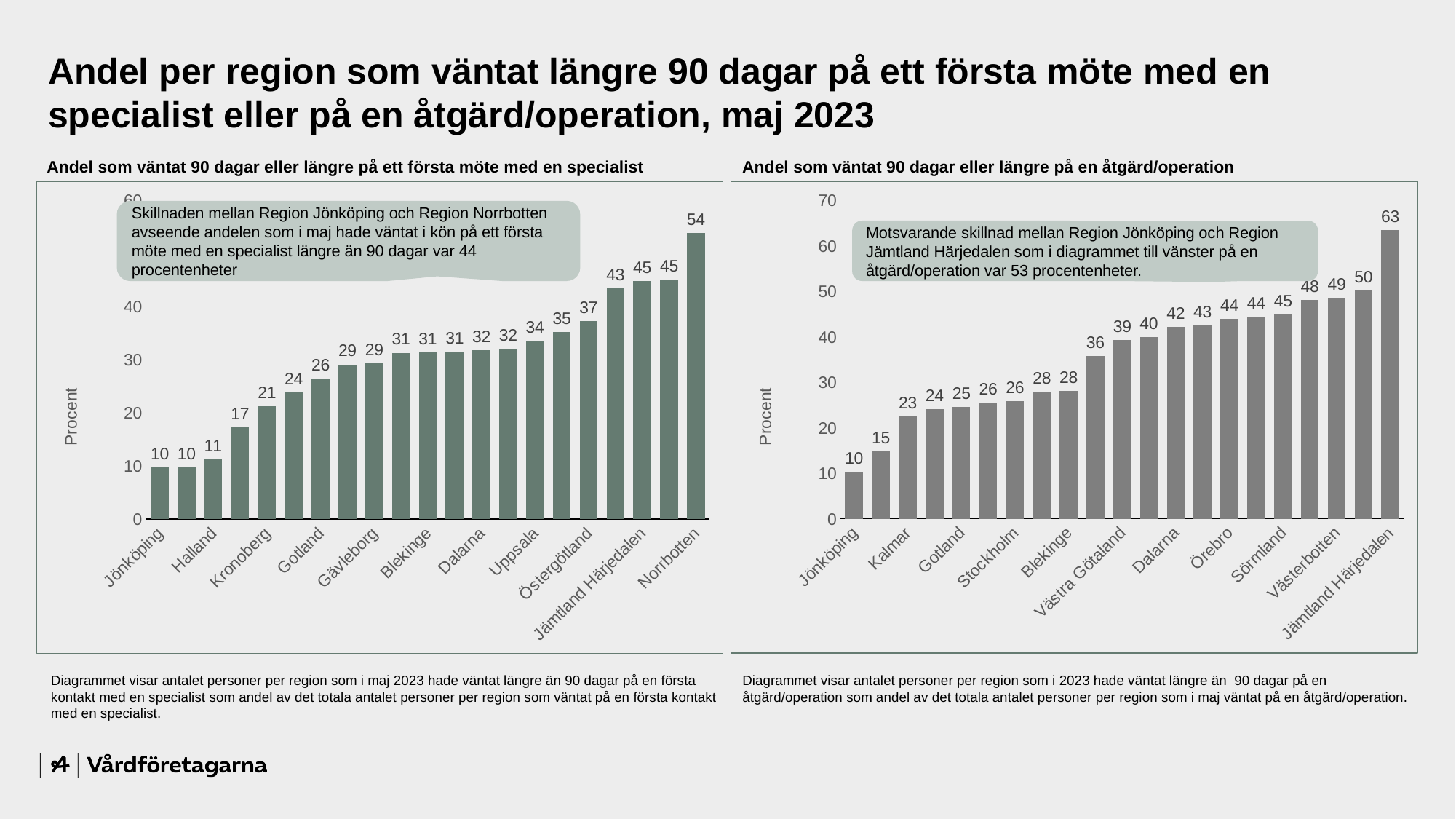
In the left chart (first meeting with a specialist), what is the value for Östergötland? 37 In the right chart (åtgärd/operation), what is the value for Västra Götaland? 39 What kind of chart is the right chart (åtgärd/operation)? bar chart In the left chart (first meeting with a specialist), what is the difference between Norrbotten and Jönköping? 44 In the left chart (first meeting with a specialist), which is larger, the value for Uppsala or the value for Kronoberg? Uppsala In the right chart (åtgärd/operation), what is the difference between Jämtland Härjedalen and Jönköping? 53 In the left chart (first meeting with a specialist), which region has the highest value? Norrbotten In the left chart (Andel som väntat 90 dagar eller längre på ett första möte med en specialist), what is the value for Norrbotten? 54 In the right chart (åtgärd/operation), do the values rise or fall from left to right along the x axis? rise In the right chart (åtgärd/operation), which region has the lowest value? Jönköping In the right chart (Andel som väntat 90 dagar eller längre på en åtgärd/operation), what is the value for Jämtland Härjedalen? 63 In the left chart (first meeting with a specialist), what is the value for Jönköping? 10